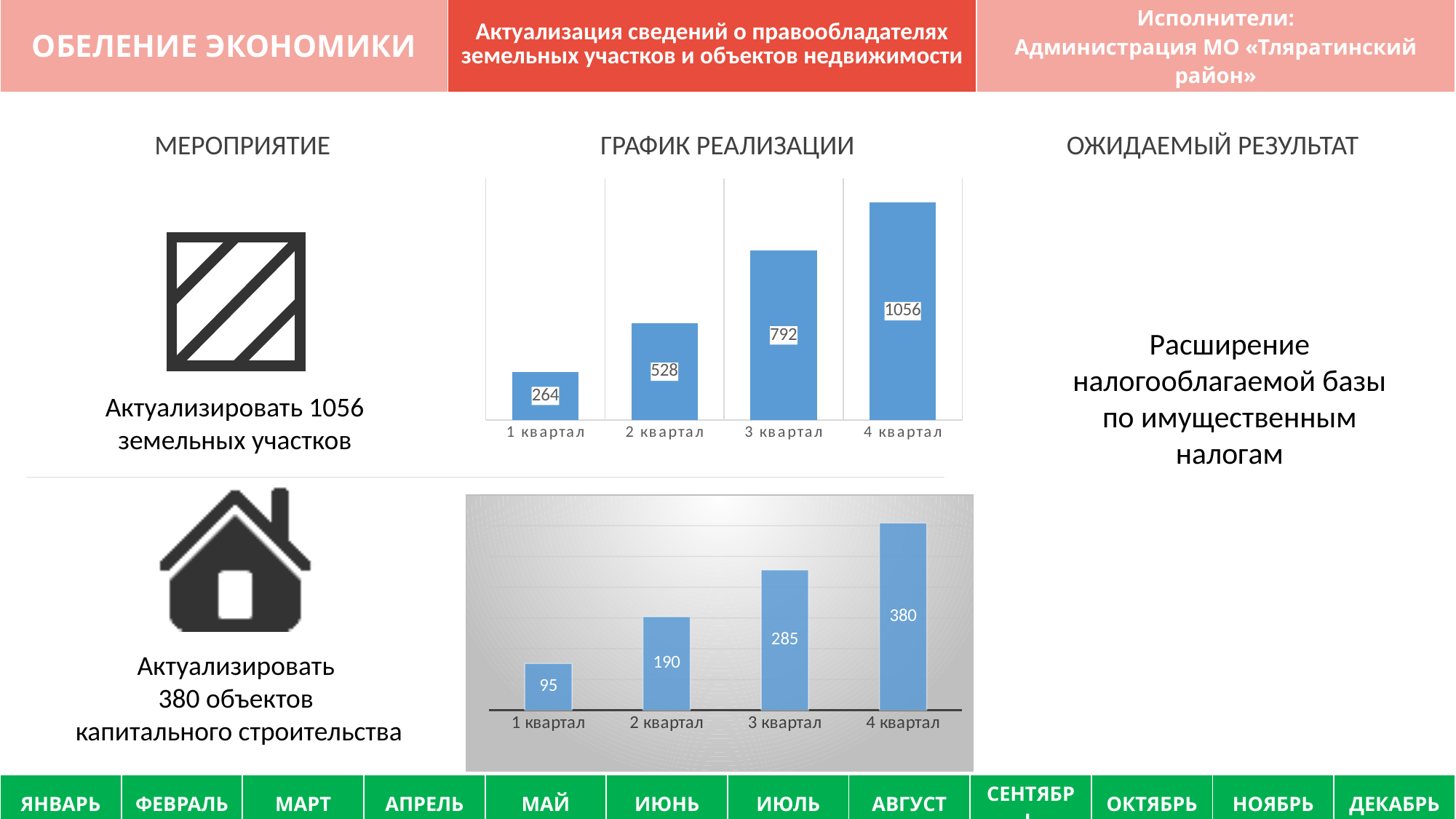
In the bottom chart, what is the value for 3 квартал? 285 In the top chart, what is the value for 2 квартал? 528 How many bars does the top chart have? 4 In the top chart, do the values rise or fall from 1 квартал to 4 квартал? rise In the bottom chart, which quarter has the highest value? 4 квартал In the top chart, which quarter has the lowest value? 1 квартал In the top chart, what is the value for 4 квартал? 1056 In the bottom chart, what is the value for 1 квартал? 95 In the top chart, what is the difference between the values for 3 квартал and 1 квартал? 528 What type of chart is the bottom chart? bar chart In the bottom chart, which is larger: the value for 2 квартал or the value for 3 квартал? 3 квартал In the bottom chart, what is the difference between the values for 4 квартал and 2 квартал? 190